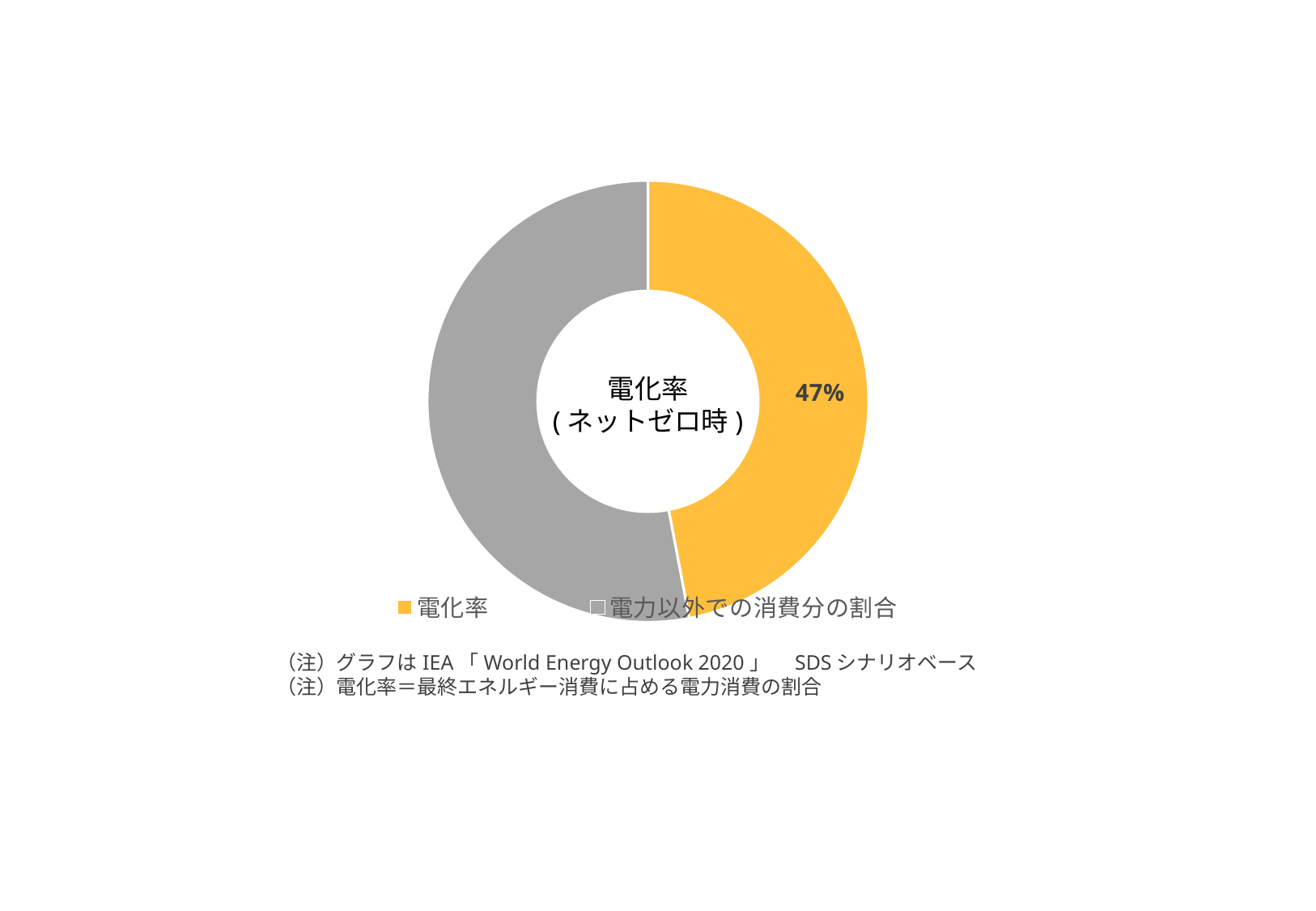
Which slice is the largest in the chart? 電力以外での消費分の割合 What kind of chart is shown on the slide? Pie (donut) chart Which slice is the smallest in the chart? 電化率 What text is shown in the centre of the donut chart? 電化率（ネットゼロ時） What is the value shown for 電化率 on the chart? 47% Is the share for 電化率 greater or less than 50%? less Which slice is larger, 電化率 or 電力以外での消費分の割合? 電力以外での消費分の割合 How many slices does the chart have? 2 How many entries does the legend list? 2 What colour is the 電化率 slice? Yellow (orange-yellow)